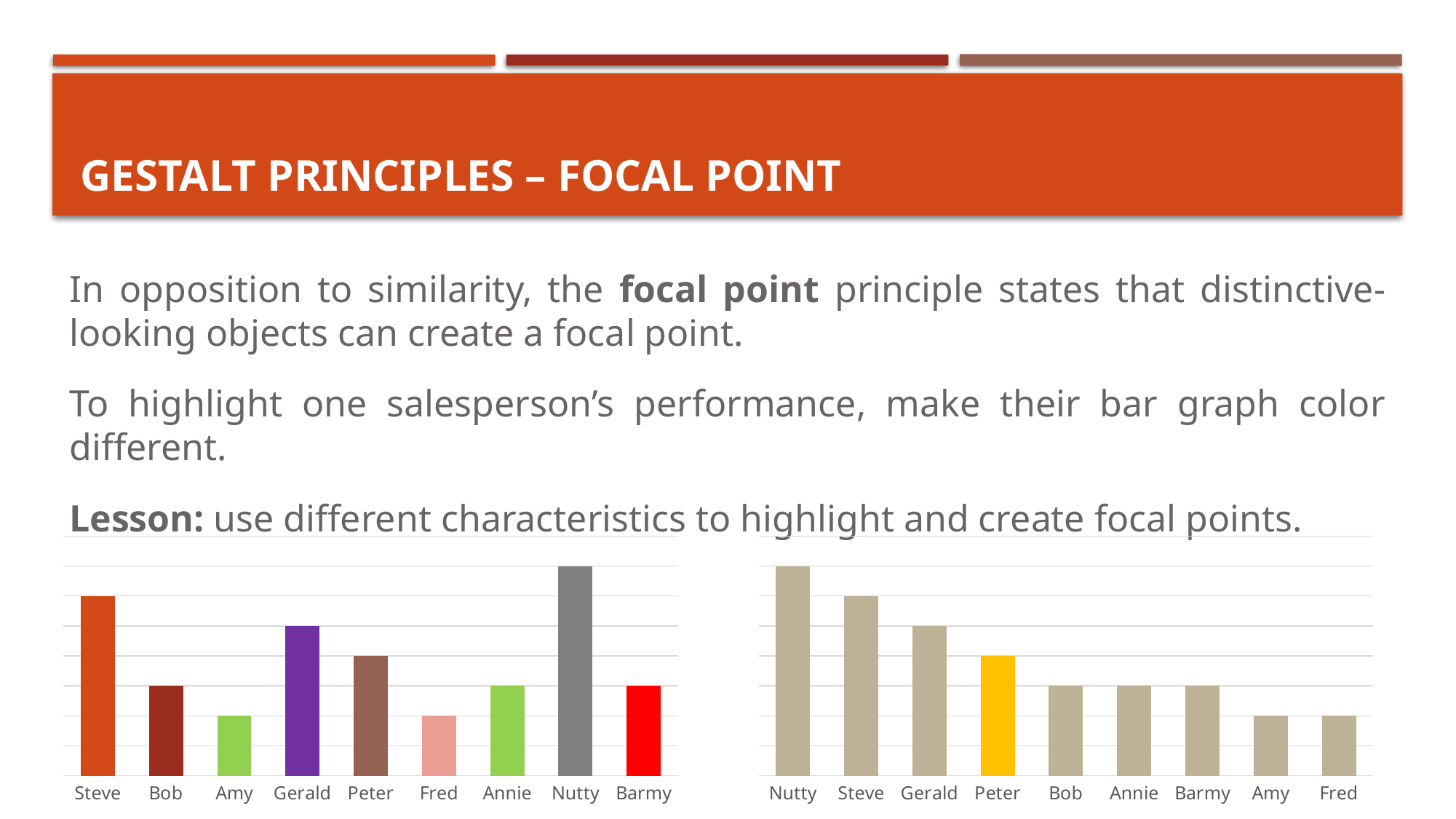
In the chart on the left, how many salespeople are shown on the x axis? 9 In the chart on the left, which is larger, the bar for Gerald or the bar for Peter? Gerald In the chart on the left, which salesperson has the highest bar? Nutty In the chart on the right, which salesperson has the highest bar? Nutty In the chart on the right, do the bar values rise or fall from left to right along the x axis? fall In the chart on the right, how many bars are there? 9 In the chart on the left, which is larger, the bar for Steve or the bar for Bob? Steve What kind of chart is the chart on the left? bar chart In the chart on the right, which is larger, the bar for Steve or the bar for Peter? Steve In the chart on the right, which salesperson's bar is coloured differently from the others? Peter In the chart on the right, which salesperson is the first category on the x axis? Nutty What kind of chart is the chart on the right? bar chart